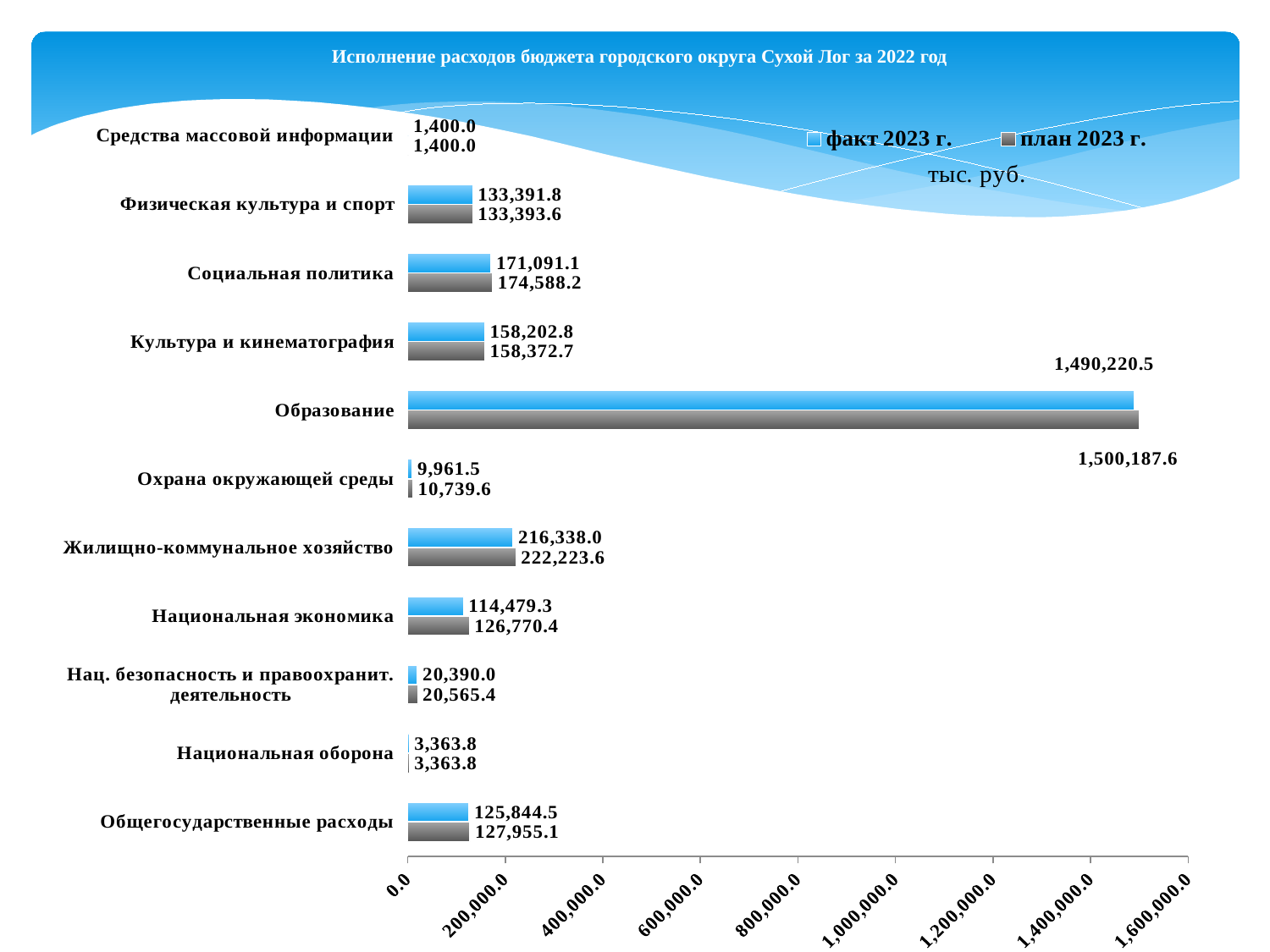
Which category has the lowest 'факт 2023 г.' value? Средства массовой информации What is the difference between 'план 2023 г.' and 'факт 2023 г.' for Национальная экономика? 12,291.1 What is the value of 'план 2023 г.' for Жилищно-коммунальное хозяйство? 222,223.6 What is the title of the chart? Исполнение расходов бюджета городского округа Сухой Лог за 2022 год What is the value of 'факт 2023 г.' for Образование? 1,490,220.5 What type of chart is shown on the slide? Bar chart Which category has the highest 'план 2023 г.' value? Образование What is the value of 'факт 2023 г.' for Охрана окружающей среды? 9,961.5 Which is larger: the 'факт 2023 г.' value for Социальная политика or for Культура и кинематография? Социальная политика How many categories are shown on the chart? 11 What unit of measurement is indicated on the chart? тыс. руб. How many series does the legend list? 2